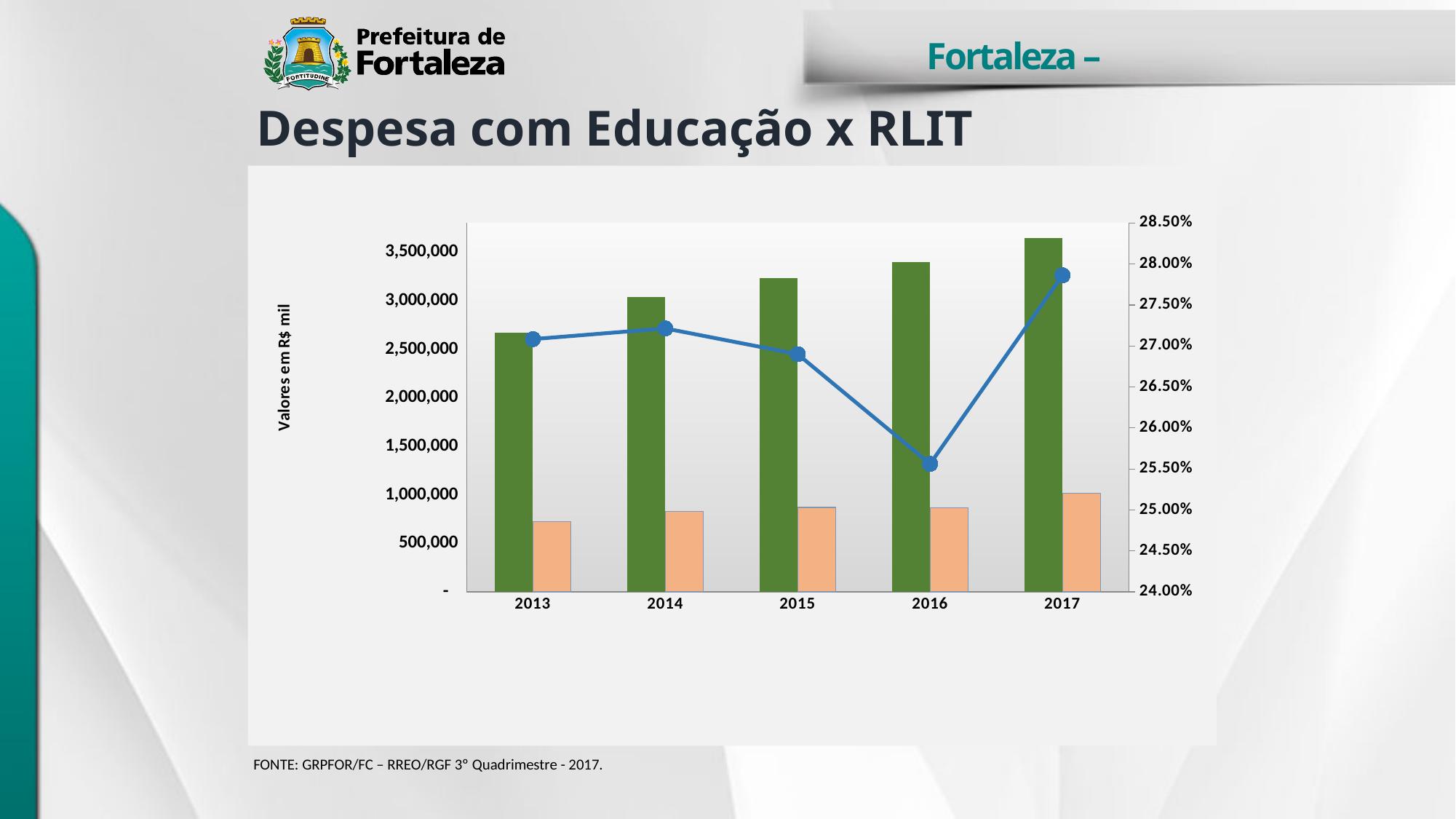
Is the value of the green bar for 2017 greater or less than 3,500,000? greater What is the label of the left vertical axis? Valores em R$ mil In which year is the green bar the shortest? 2013 In which year is the green bar the tallest? 2017 In which year does the blue line reach its highest point? 2017 In which year does the blue line reach its lowest point? 2016 Is the value of the blue line for 2016 greater or less than 26.00%? less How many years are shown on the x axis of the chart? 5 Which is larger, the blue line value for 2015 or for 2016? 2015 What is the title of the chart on the slide? Despesa com Educação x RLIT Is the value of the orange bar for 2013 greater or less than 1,000,000? less Do the green bars rise or fall from 2013 to 2017? rise